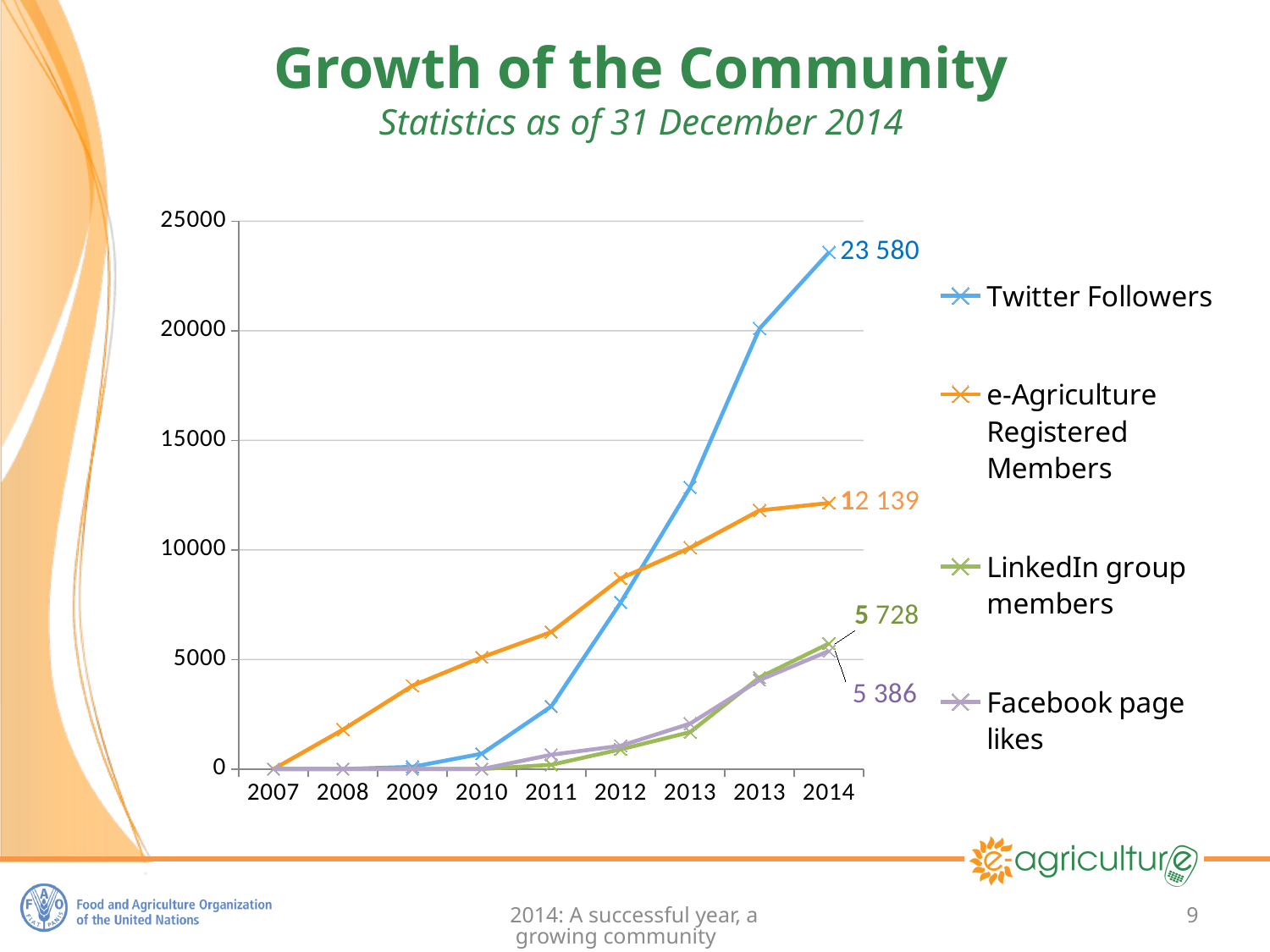
What is the value for e-Agriculture Registered Members in 2014? 12 139 Which series has the lowest value in 2014? Facebook page likes What is the value for LinkedIn group members in 2014? 5 728 How many series does the legend list? 4 What is the value for Twitter Followers in 2014? 23 580 Is the value for Twitter Followers in 2013 (the first 2013 point) greater or less than 15000? less What kind of chart is shown on the slide? Line chart What is the difference between Twitter Followers and e-Agriculture Registered Members in 2014? 11 441 What is the value for Facebook page likes in 2014? 5 386 In 2012, which is larger: Twitter Followers or e-Agriculture Registered Members? e-Agriculture Registered Members What is the difference between LinkedIn group members and Facebook page likes in 2014? 342 Which series has the highest value in 2014? Twitter Followers